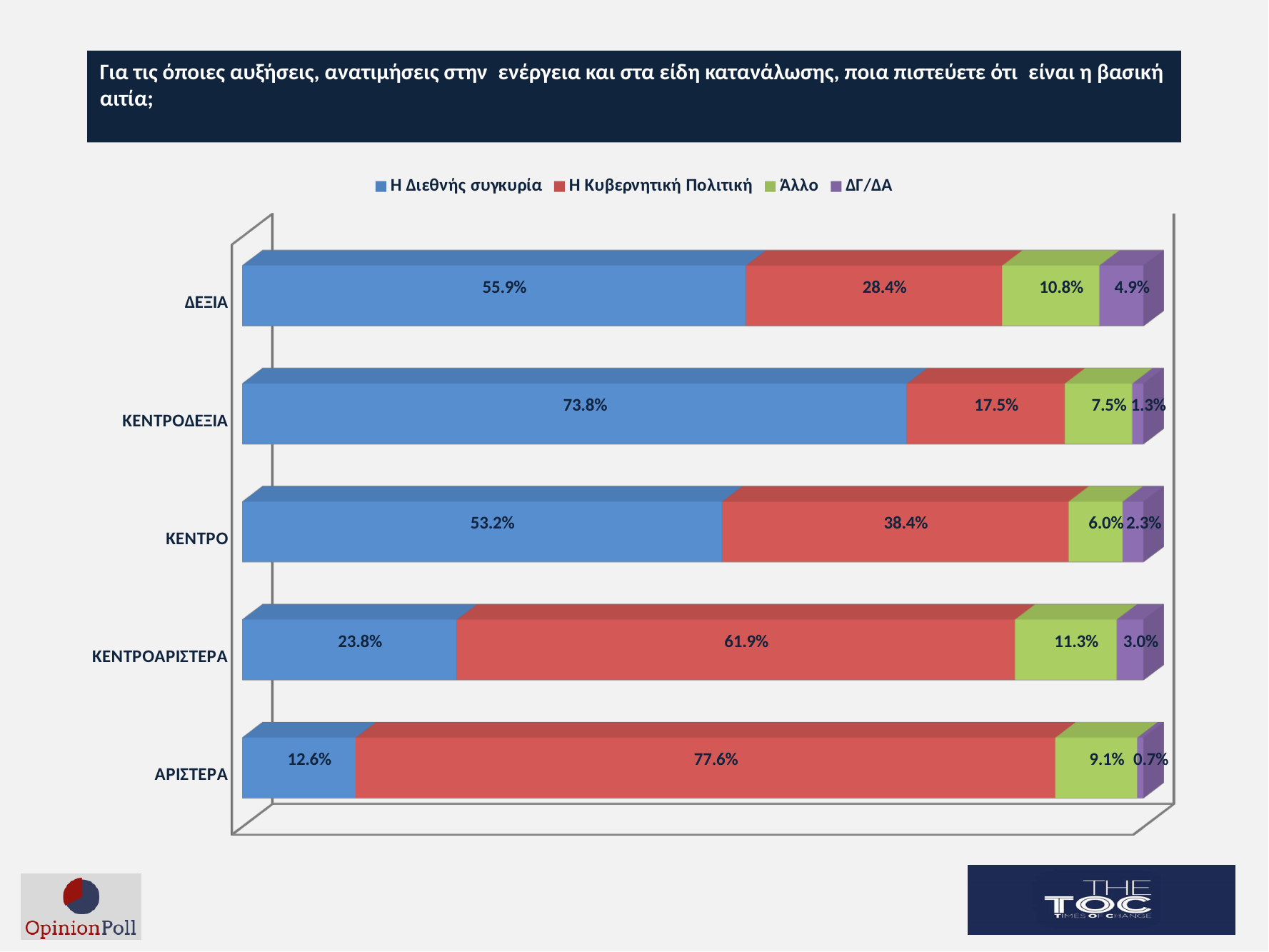
What is the value of Άλλο for ΚΕΝΤΡΟΑΡΙΣΤΕΡΑ? 11.3% Which is larger for ΚΕΝΤΡΟ: Η Διεθνής συγκυρία or Η Κυβερνητική Πολιτική? Η Διεθνής συγκυρία Which category has the lowest value for Η Κυβερνητική Πολιτική? ΚΕΝΤΡΟΔΕΞΙΑ What is the value of Η Κυβερνητική Πολιτική for ΑΡΙΣΤΕΡΑ? 77.6% Which series is shown in green in the legend? Άλλο What kind of chart is shown on the slide? Stacked bar chart What is the value of ΔΓ/ΔΑ for ΔΕΞΙΑ? 4.9% What is the difference between the Η Κυβερνητική Πολιτική values for ΚΕΝΤΡΟ and ΔΕΞΙΑ? 10.0% Which category has the highest value for Η Διεθνής συγκυρία? ΚΕΝΤΡΟΔΕΞΙΑ How many series does the legend list? 4 What is the value of Η Διεθνής συγκυρία for ΚΕΝΤΡΟΔΕΞΙΑ? 73.8% How many categories are shown on the vertical axis? 5